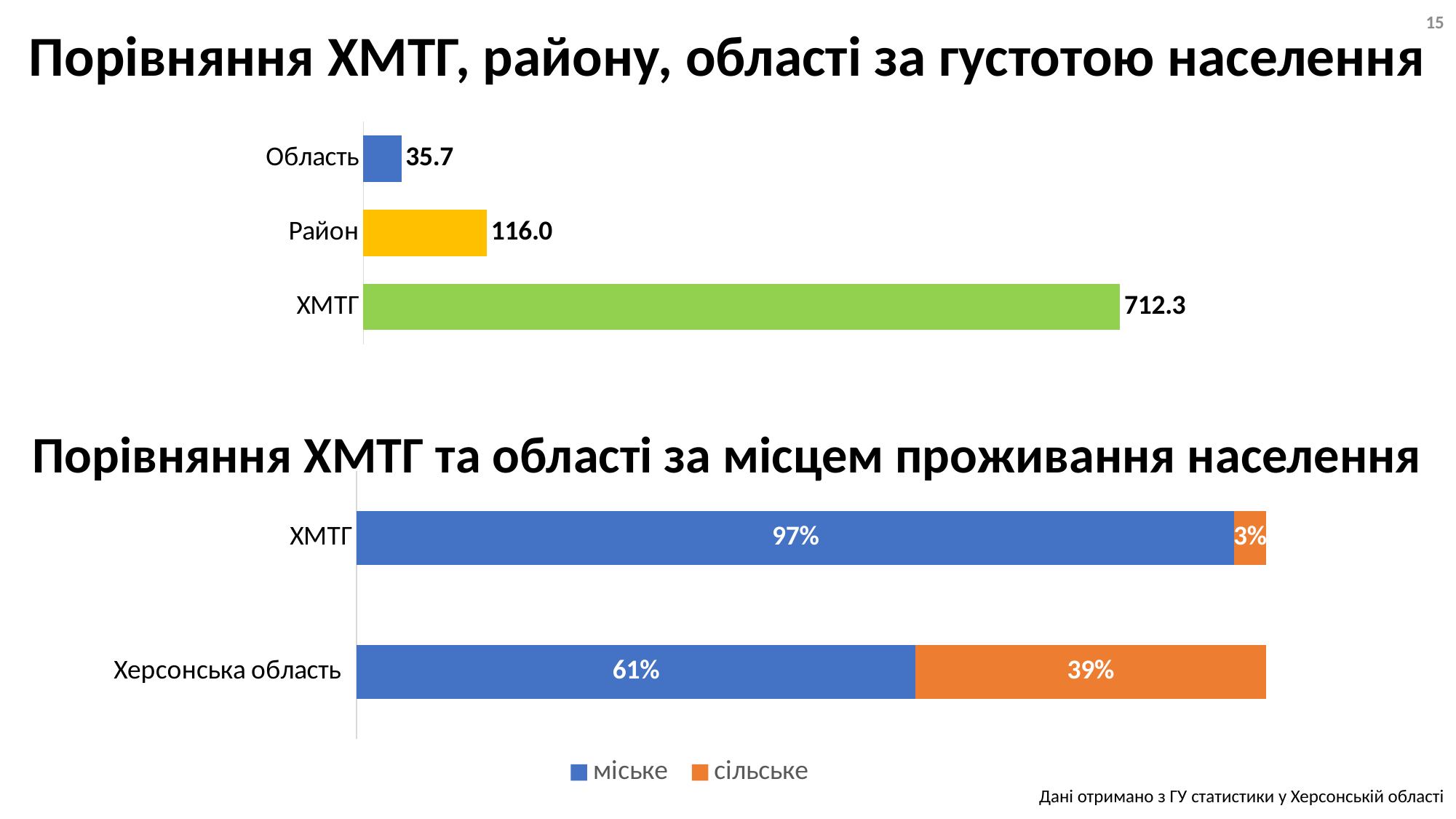
In the bottom chart (place of residence comparison), what is the share of міське for ХМТГ? 97% In the top chart (population density comparison), what is the value for Область? 35.7 What type of chart is the top chart (population density comparison)? Bar chart In the top chart (population density comparison), what is the difference between the values for ХМТГ and Район? 596.3 In the top chart (population density comparison), which category has the lowest value? Область In the top chart (population density comparison), how many categories are shown? 3 In the bottom chart (place of residence comparison), which has a larger сільське share: ХМТГ or Херсонська область? Херсонська область In the top chart (population density comparison), which category has the highest value? ХМТГ In the top chart (population density comparison), what is the value for ХМТГ? 712.3 In the top chart (population density comparison), what is the value for Район? 116.0 In the bottom chart (place of residence comparison), how many series does the legend list? 2 In the bottom chart (place of residence comparison), what is the share of сільське for Херсонська область? 39%